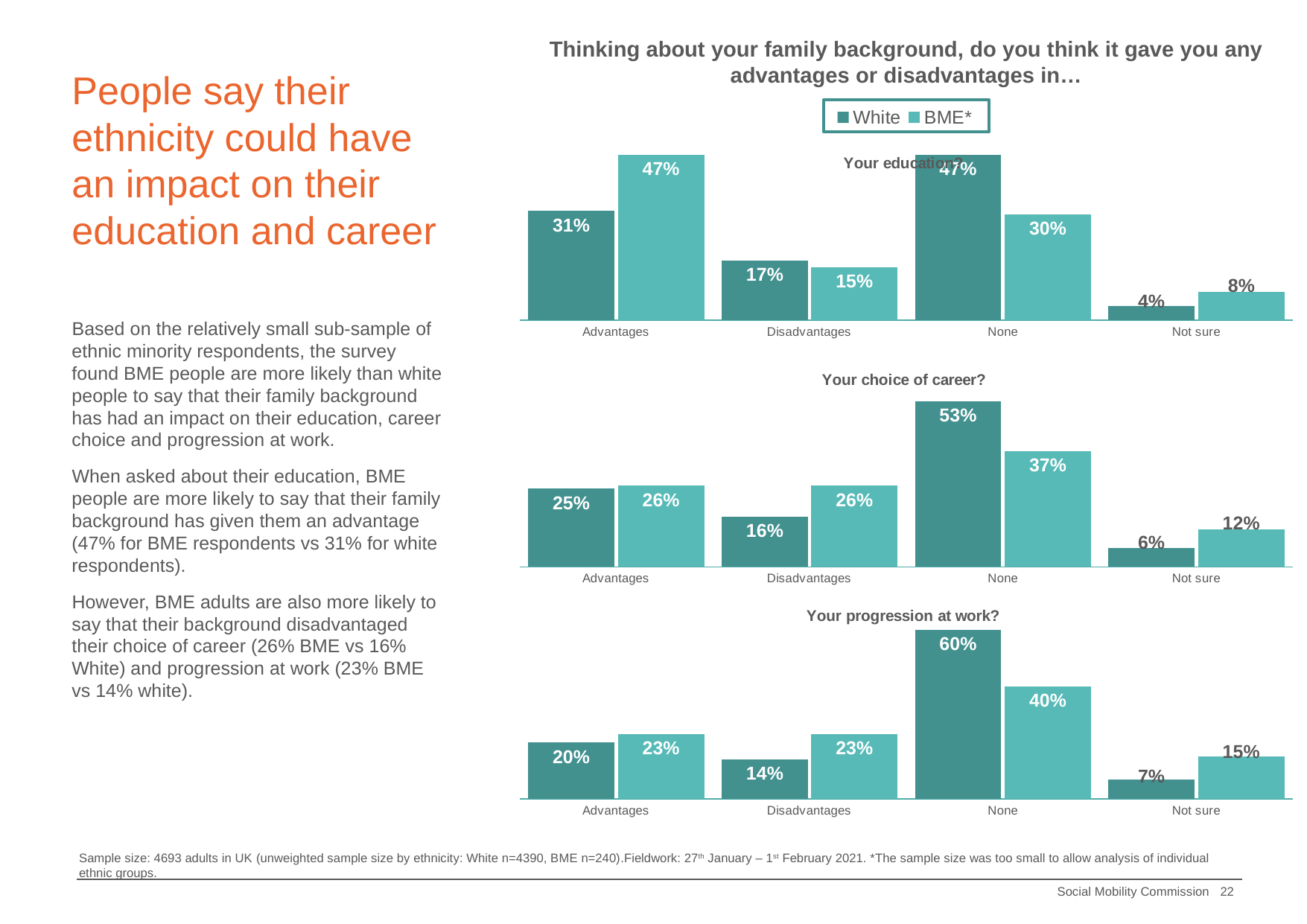
What type of chart is the 'Your progression at work?' chart? Bar chart In the 'Your choice of career?' chart, which is larger for Disadvantages: the White value or the BME value? BME In the 'Your education?' chart, what is the value for BME respondents in the Advantages category? 47% In the 'Your progression at work?' chart, which category has the highest value for White respondents? None How many categories are shown on the x axis of the 'Your choice of career?' chart? 4 In the 'Your progression at work?' chart, what is the difference between the White and BME values for Disadvantages? 9% In the 'Your choice of career?' chart, what is the value for White respondents in the None category? 53% In the 'Your progression at work?' chart, what is the value for BME respondents in the None category? 40% In the 'Your choice of career?' chart, which category has the lowest value for White respondents? Not sure How many series does the legend list for the charts? 2 In the 'Your education?' chart, what is the difference between the White and BME values for Advantages? 16% In the 'Your education?' chart, what is the value for White respondents in the Not sure category? 4%